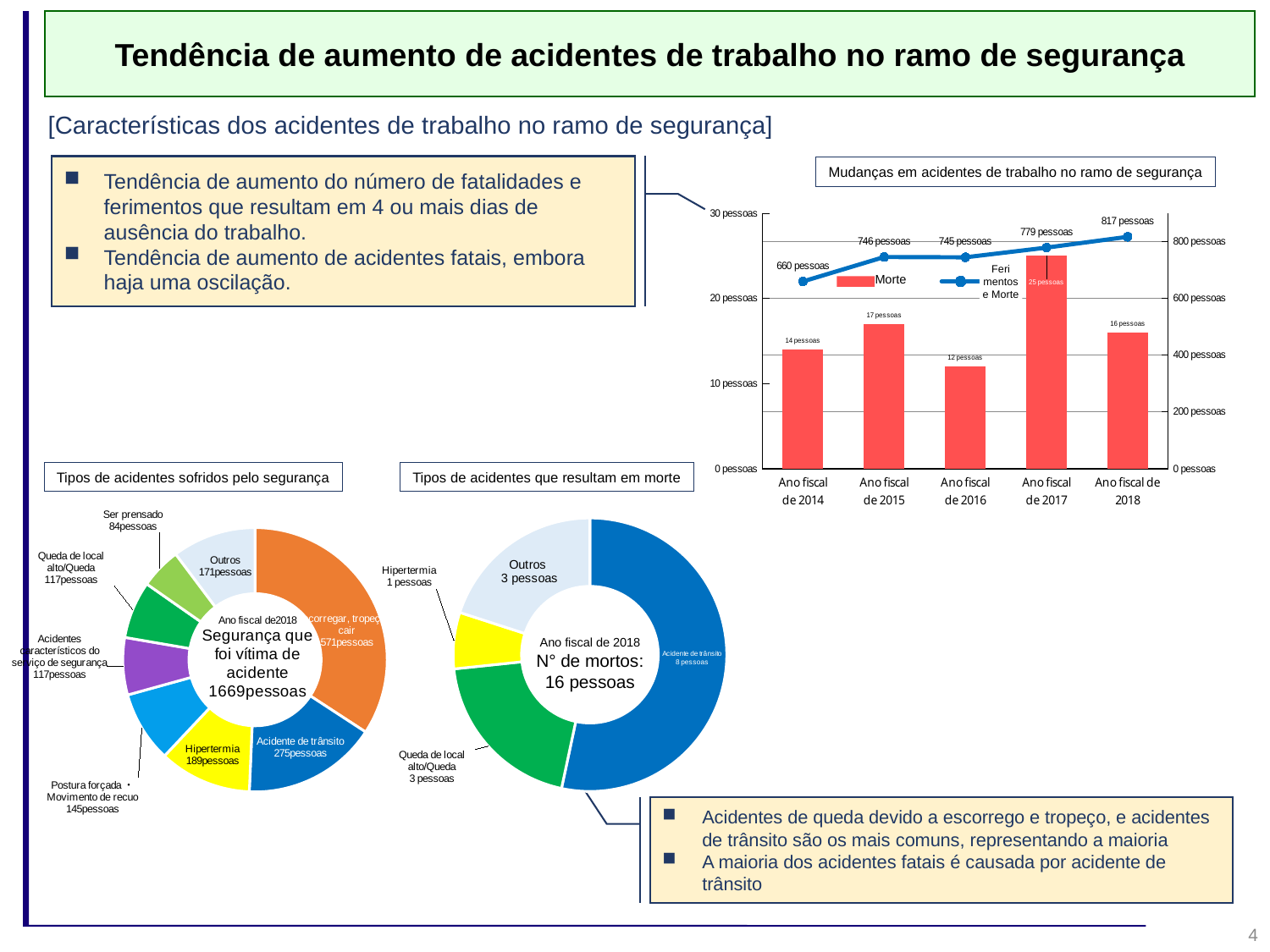
What kind of chart is 'Tipos de acidentes que resultam em morte'? Donut (pie) chart In the chart 'Mudanças em acidentes de trabalho no ramo de segurança', which fiscal year has the lowest Morte value? Ano fiscal de 2016 In the chart 'Mudanças em acidentes de trabalho no ramo de segurança', is the Morte value for Ano fiscal de 2015 greater or less than 20 pessoas? less In the chart 'Mudanças em acidentes de trabalho no ramo de segurança', what is the value of the 'Ferimentos e Morte' line for Ano fiscal de 2018? 817 pessoas In the chart 'Mudanças em acidentes de trabalho no ramo de segurança', how many series does the legend list? 2 In the chart 'Mudanças em acidentes de trabalho no ramo de segurança', which fiscal year has the highest Morte value? Ano fiscal de 2017 In the chart 'Mudanças em acidentes de trabalho no ramo de segurança', what is the difference between the 'Ferimentos e Morte' values for Ano fiscal de 2018 and Ano fiscal de 2014? 157 pessoas In the chart 'Tipos de acidentes que resultam em morte', what share of the 16 deaths is 'Acidente de trânsito'? 50% In the chart 'Mudanças em acidentes de trabalho no ramo de segurança', how many fiscal years are shown on the x axis? 5 In the chart 'Mudanças em acidentes de trabalho no ramo de segurança', what is the value of the Morte bar for Ano fiscal de 2017? 25 pessoas In the chart 'Tipos de acidentes sofridos pelo segurança', which category has the largest slice? Escorregar, tropeçar e cair In the chart 'Tipos de acidentes sofridos pelo segurança', how many people suffered 'Acidente de trânsito'? 275pessoas